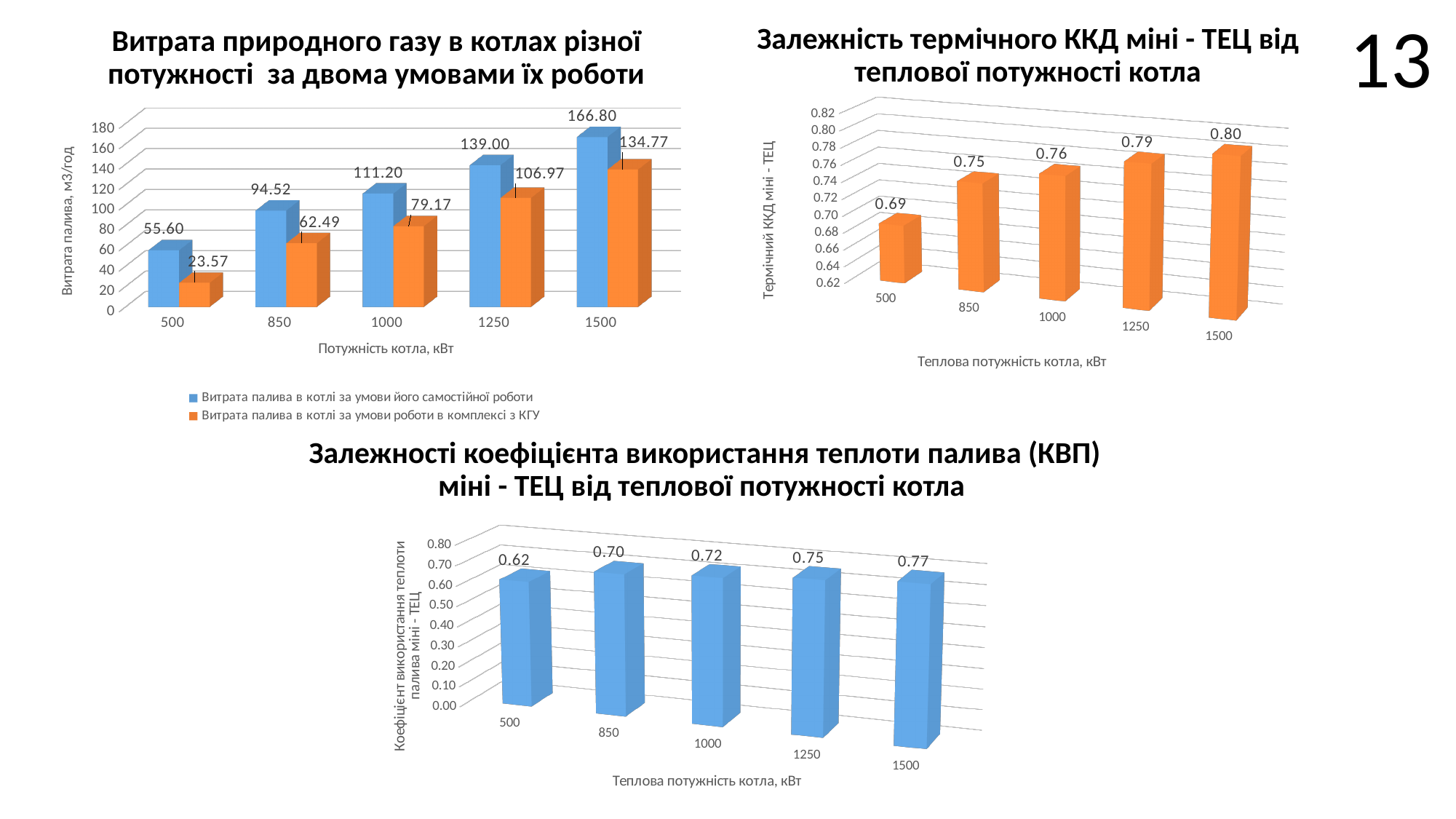
In the top-left chart (Витрата природного газу в котлах різної потужності), how many series does the legend list? 2 In the top-left chart (Витрата природного газу в котлах різної потужності), what is the difference between the two series for the 1500 kW boiler? 32.03 In the bottom chart (Залежності коефіцієнта використання теплоти палива), how many boiler power categories are shown? 5 What type of chart is the bottom chart (Залежності коефіцієнта використання теплоти палива)? bar chart In the top-right chart (Залежність термічного ККД міні-ТЕЦ від теплової потужності котла), do the values rise or fall as boiler power increases? rise In the top-right chart (Залежність термічного ККД міні-ТЕЦ від теплової потужності котла), which boiler power has the highest thermal efficiency? 1500 In the top-left chart (Витрата природного газу в котлах різної потужності), is the blue bar for 1000 kW greater or less than 100? greater In the top-left chart (Витрата природного газу в котлах різної потужності), what is the fuel consumption for the 1250 kW boiler under standalone operation (blue series)? 139.00 In the top-right chart (Залежність термічного ККД міні-ТЕЦ від теплової потужності котла), what is the thermal efficiency for the 850 kW boiler? 0.75 In the top-left chart (Витрата природного газу в котлах різної потужності), what is the fuel consumption for the 500 kW boiler when operating in combination with КГУ (orange series)? 23.57 In the bottom chart (Залежності коефіцієнта використання теплоти палива), what is the value for the 1000 kW boiler? 0.72 In the top-left chart (Витрата природного газу в котлах різної потужності), which boiler power has the lowest fuel consumption in the orange series? 500